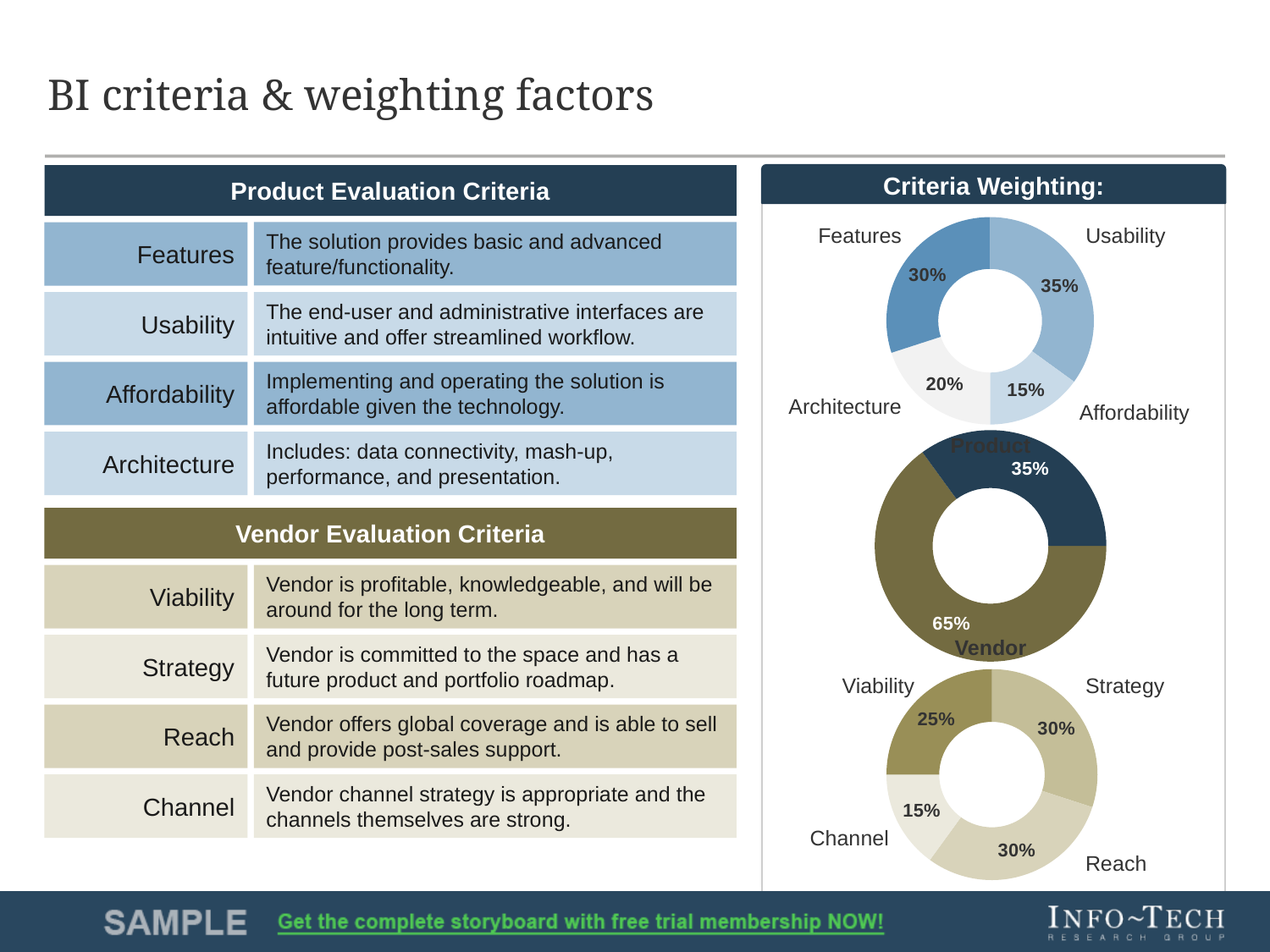
In the top donut chart under Criteria Weighting, which criterion has the lowest weighting? Affordability In the top donut chart under Criteria Weighting, what is the weighting for Usability? 35% In the bottom donut chart under Criteria Weighting, what is the difference between the Strategy and Channel weightings? 15% In the top donut chart under Criteria Weighting, which criterion has the highest weighting? Usability In the top donut chart under Criteria Weighting, what is the difference between the Features and Affordability weightings? 15% In the middle donut chart under Criteria Weighting, which is larger, Product or Vendor? Vendor In the bottom donut chart under Criteria Weighting, what is the weighting for Channel? 15% What kind of chart is used for the Criteria Weighting section? Donut chart In the bottom donut chart under Criteria Weighting, what is the weighting for Viability? 25% In the middle donut chart under Criteria Weighting, what is the weighting for Vendor? 65% In the top donut chart under Criteria Weighting, what is the weighting for Architecture? 20% In the bottom donut chart under Criteria Weighting, how many criteria are shown? 4